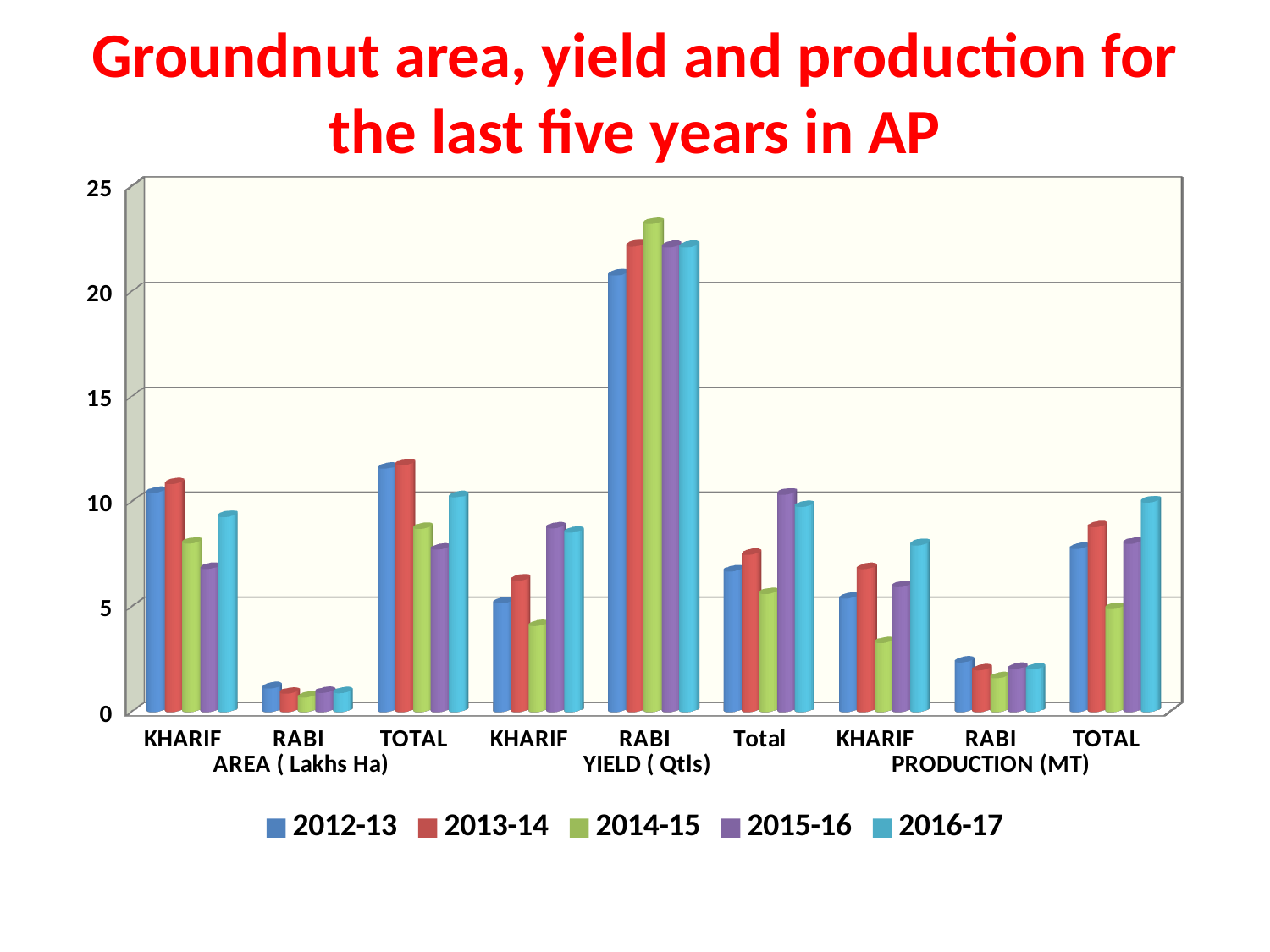
Is the value for TOTAL under PRODUCTION (MT) for 2016-17 greater or less than 5? greater Is the value for RABI under YIELD (Qtls) for 2014-15 greater or less than 20? greater How many categories are shown along the x axis? 9 Is the value for KHARIF under AREA (Lakhs Ha) for 2015-16 greater or less than 10? less For TOTAL under PRODUCTION (MT), which is larger: 2016-17 or 2014-15? 2016-17 Which year has the lowest bar for KHARIF under AREA (Lakhs Ha)? 2015-16 What colour are the bars for the 2014-15 series? green What kind of chart is shown on the slide? bar chart Which year has the lowest bar for KHARIF under PRODUCTION (MT)? 2014-15 For Total under YIELD (Qtls), which is larger: 2015-16 or 2014-15? 2015-16 How many series does the legend list? 5 Which year has the highest bar for RABI under YIELD (Qtls)? 2014-15